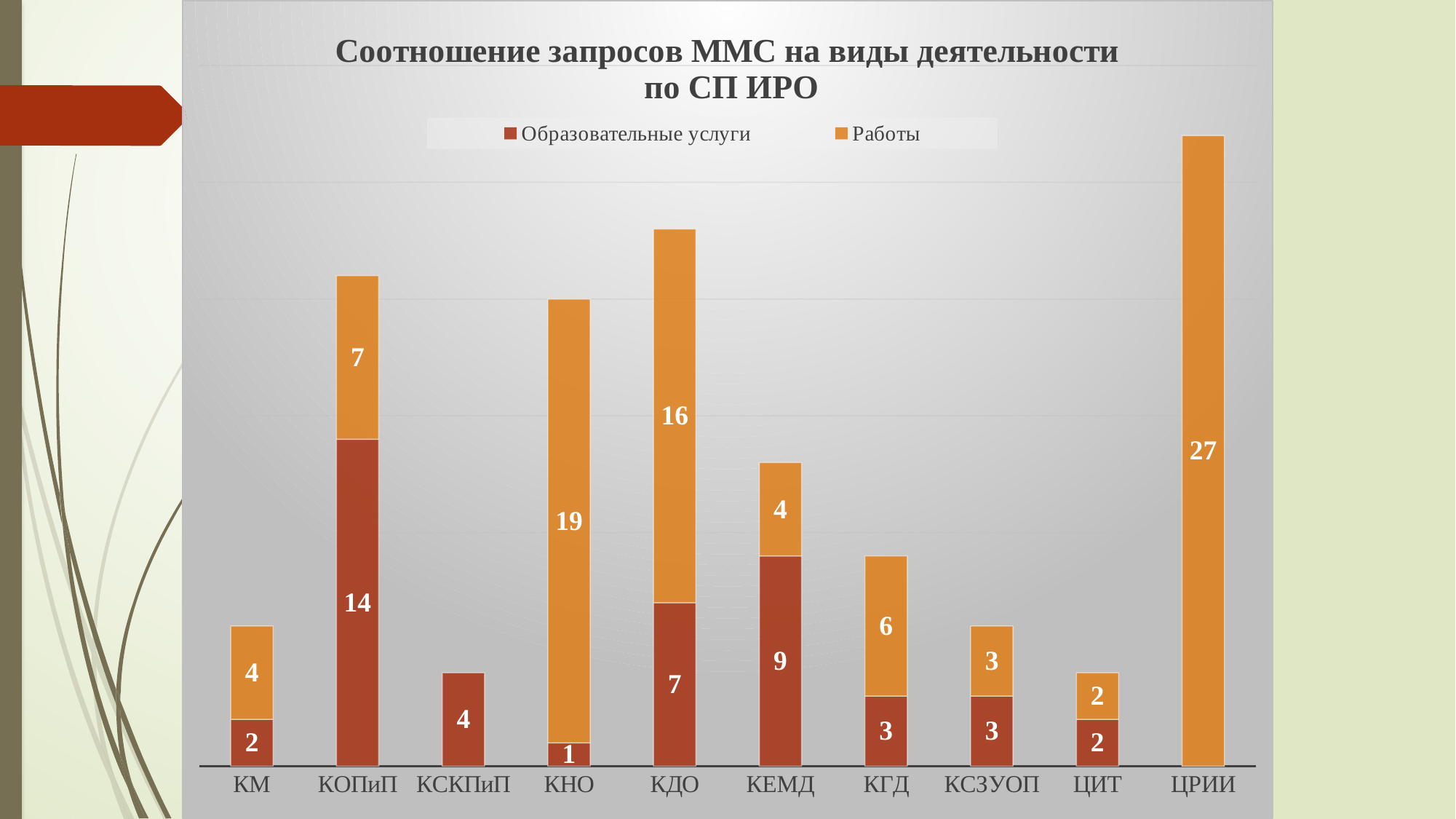
How many series does the legend list? 2 What is the total of the stacked bar for КДО? 23 How many categories are shown on the x axis? 10 What is the value of Образовательные услуги for КОПиП? 14 What is the difference between the Работы value for КДО and the Работы value for КЕМД? 12 Which is larger: the Образовательные услуги value for КЕМД or for КДО? КЕМД Which category has the lowest value for Образовательные услуги among those with a labelled value? КНО What is the value of Работы for ЦРИИ? 27 What type of chart is shown on the slide? Stacked bar chart What is the value of Работы for КНО? 19 What is the title of the chart? Соотношение запросов ММС на виды деятельности по СП ИРО Which category has the highest value for Работы? ЦРИИ